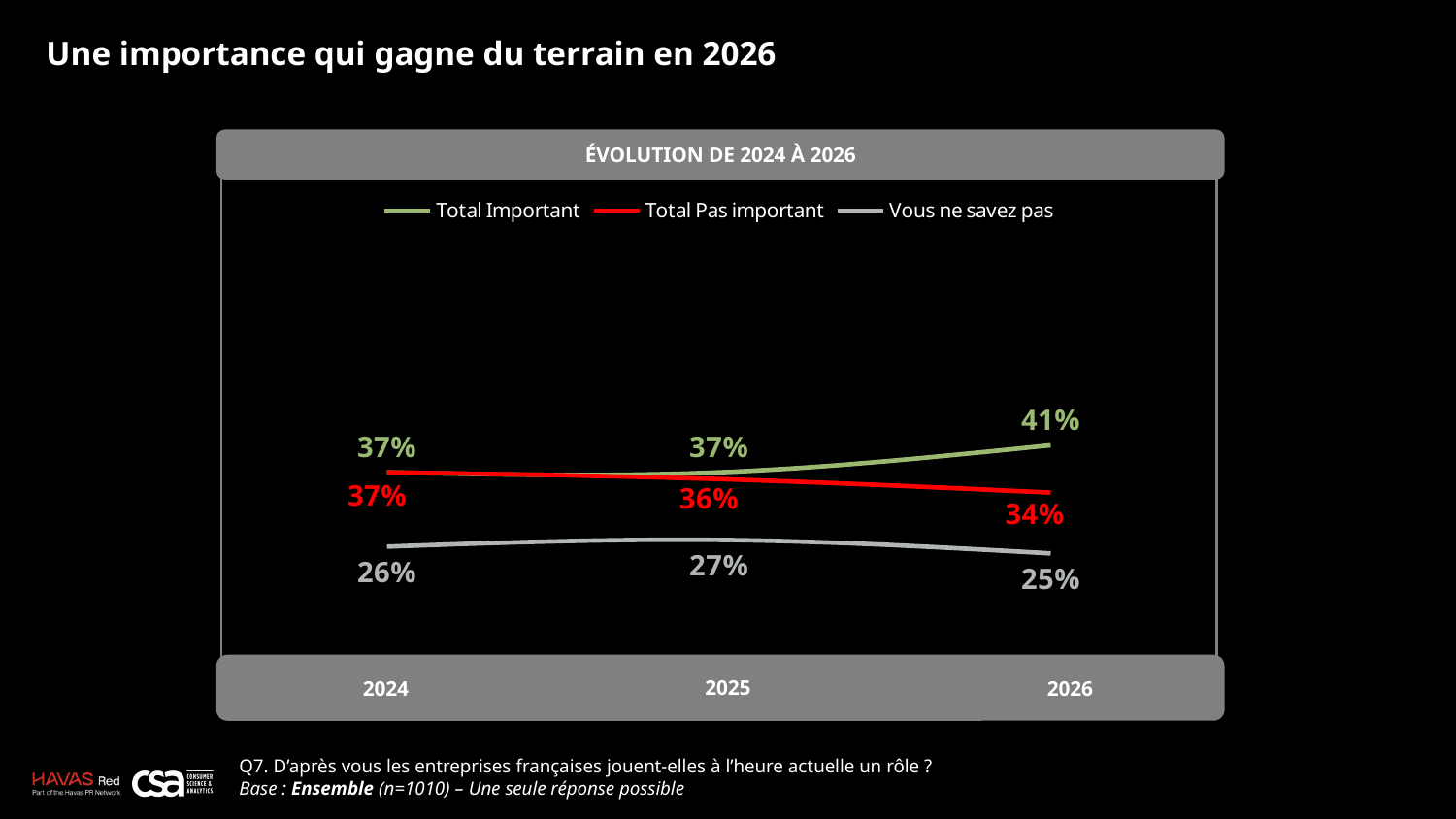
What is the value for Total Important in 2026? 41% Does Total Pas important rise or fall from 2024 to 2026? Fall What is the value for Total Pas important in 2026? 34% What is the value for Total Pas important in 2025? 36% What kind of chart is shown? Line chart What is the difference between Total Important and Total Pas important in 2026? 7 points How many series does the legend list? 3 In which year is Vous ne savez pas lowest? 2026 Which is larger in 2025: Total Important or Vous ne savez pas? Total Important In which year is Total Important highest? 2026 How many years are shown on the x axis? 3 What is the value for Vous ne savez pas in 2024? 26%